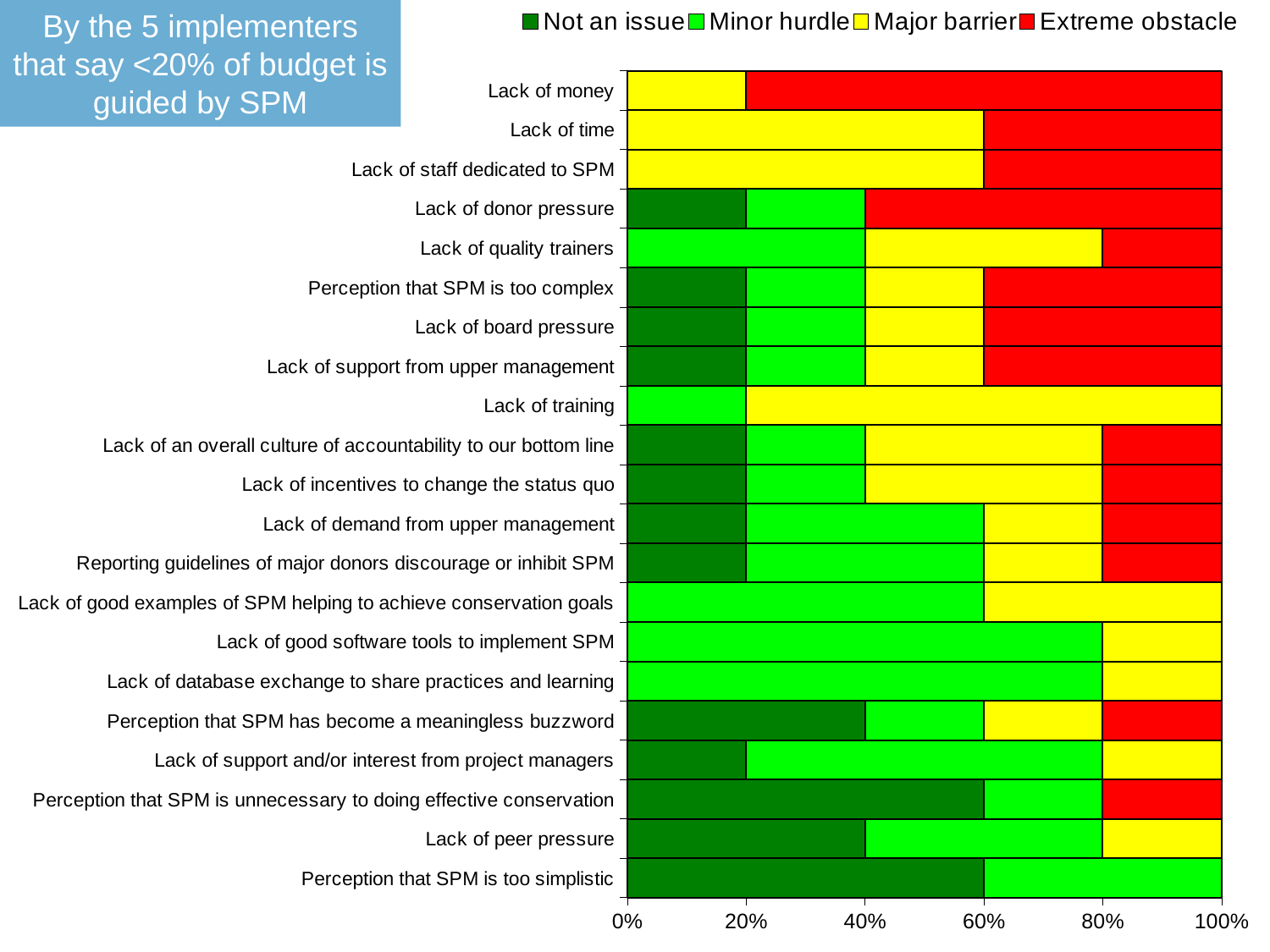
How many series does the legend list? 4 What is the total of the stacked bar for 'Lack of peer pressure'? 100% What is the difference between the Extreme obstacle share for 'Lack of money' and for 'Lack of donor pressure'? 20% How many categories (barriers) are plotted on the chart? 21 What kind of chart is shown on the slide? Stacked bar chart Which category has the largest Extreme obstacle share? Lack of money What share of respondents rated 'Perception that SPM is too simplistic' as Not an issue? 60% Which category has the largest Major barrier share? Lack of training Which is larger: the Extreme obstacle share for 'Lack of money' or for 'Lack of time'? Lack of money What share of respondents rated 'Lack of training' as a Major barrier? 80% What share of respondents rated 'Lack of money' as an Extreme obstacle? 80% What share of respondents rated 'Lack of time' as a Major barrier? 60%